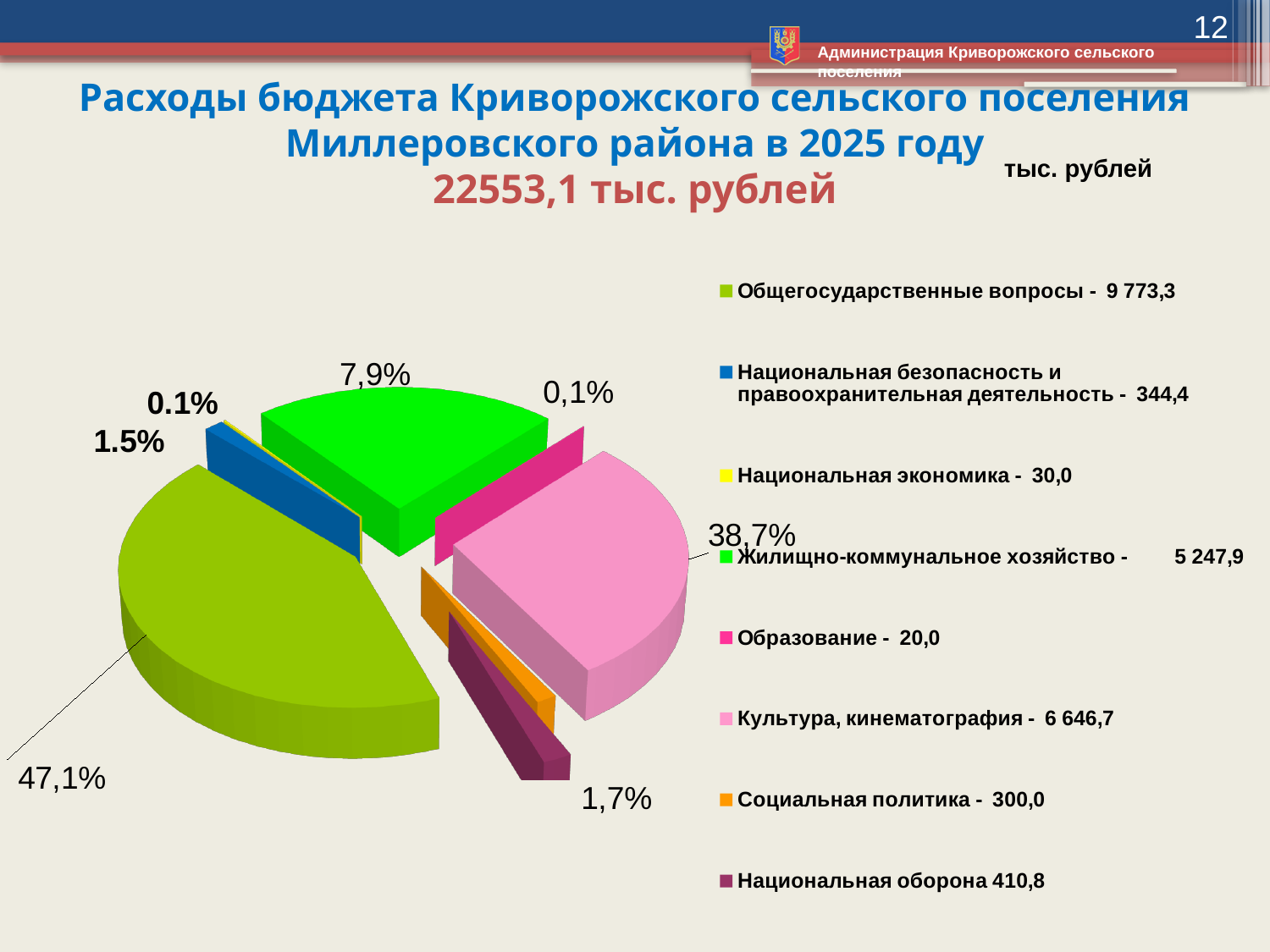
What kind of chart is shown on the slide? Pie chart How many categories does the legend of the pie chart list? 8 What value is given in the legend for Жилищно-коммунальное хозяйство? 5 247,9 What is the difference between the values for Общегосударственные вопросы and Культура, кинематография? 3 126,6 What share of the pie is labelled for the Общегосударственные вопросы slice? 47,1% Which is larger: the value for Социальная политика or for Национальная оборона? Национальная оборона What value is given in the legend for Национальная оборона? 410,8 What value is given in the legend for Культура, кинематография? 6 646,7 Which category has the smallest value in the legend? Образование What value is given in the legend for Общегосударственные вопросы? 9 773,3 Which category has the largest value in the legend? Общегосударственные вопросы What total budget expenditure is stated in the chart title? 22553,1 тыс. рублей